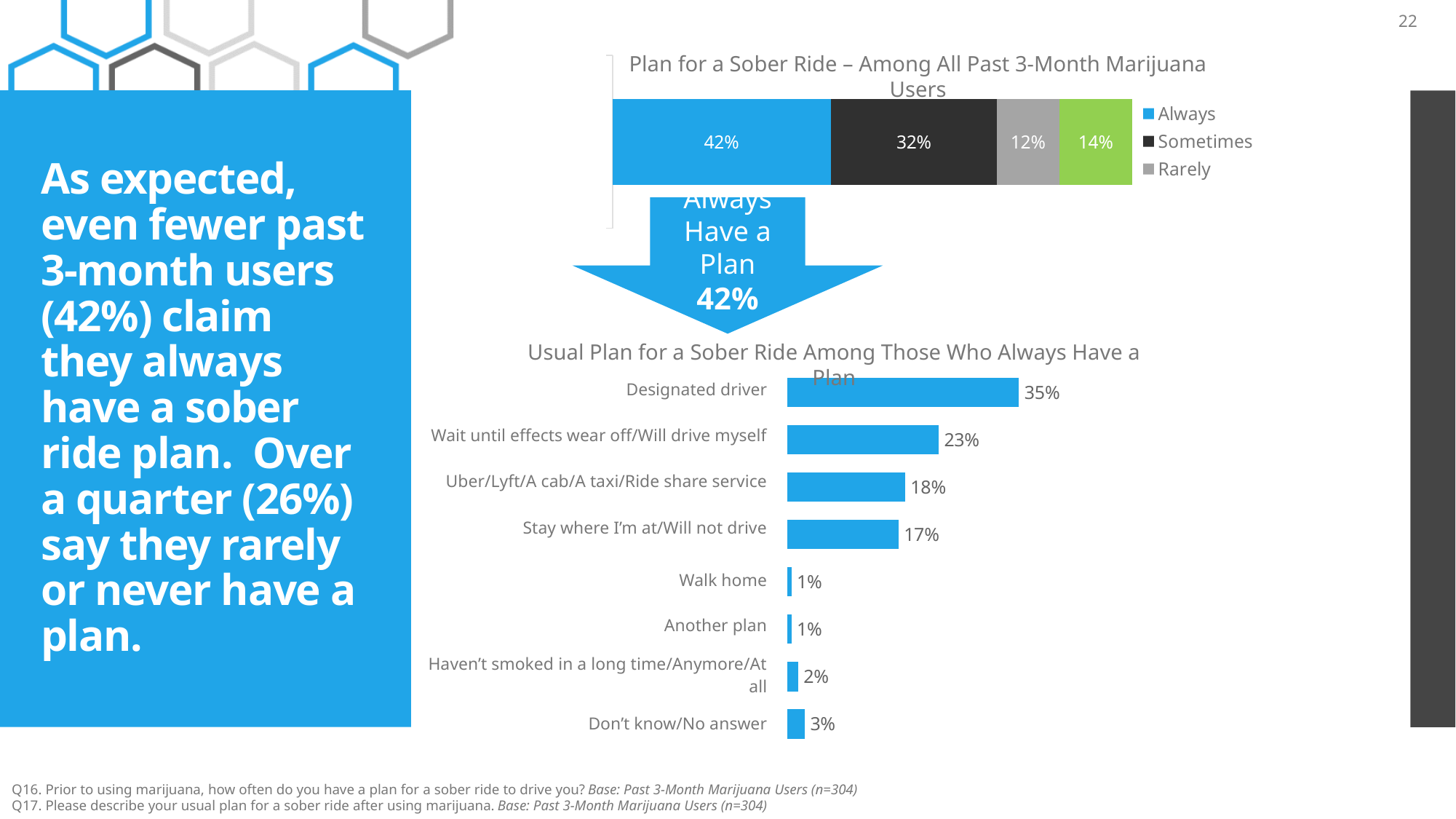
In the bottom chart 'Usual Plan for a Sober Ride Among Those Who Always Have a Plan', what is the difference between Designated driver and Uber/Lyft/A cab/A taxi/Ride share service? 17 percentage points In the top chart 'Plan for a Sober Ride – Among All Past 3-Month Marijuana Users', what percentage is shown for Sometimes? 32% In the top chart 'Plan for a Sober Ride – Among All Past 3-Month Marijuana Users', what percentage is shown for Always? 42% In the top chart 'Plan for a Sober Ride – Among All Past 3-Month Marijuana Users', what percentage is shown for Rarely? 12% In the top chart 'Plan for a Sober Ride – Among All Past 3-Month Marijuana Users', what do the four segments of the stacked bar add up to? 100% In the bottom chart 'Usual Plan for a Sober Ride Among Those Who Always Have a Plan', which category has the highest value? Designated driver In the bottom chart 'Usual Plan for a Sober Ride Among Those Who Always Have a Plan', what percentage is shown for Designated driver? 35% How many categories are plotted in the bottom chart 'Usual Plan for a Sober Ride Among Those Who Always Have a Plan'? 8 What kind of chart is the bottom chart 'Usual Plan for a Sober Ride Among Those Who Always Have a Plan'? Bar chart In the bottom chart 'Usual Plan for a Sober Ride Among Those Who Always Have a Plan', which is larger: Wait until effects wear off/Will drive myself or Stay where I'm at/Will not drive? Wait until effects wear off/Will drive myself In the top chart 'Plan for a Sober Ride – Among All Past 3-Month Marijuana Users', how many percentage points higher is Always than Sometimes? 10 percentage points In the bottom chart 'Usual Plan for a Sober Ride Among Those Who Always Have a Plan', what percentage is shown for Uber/Lyft/A cab/A taxi/Ride share service? 18%